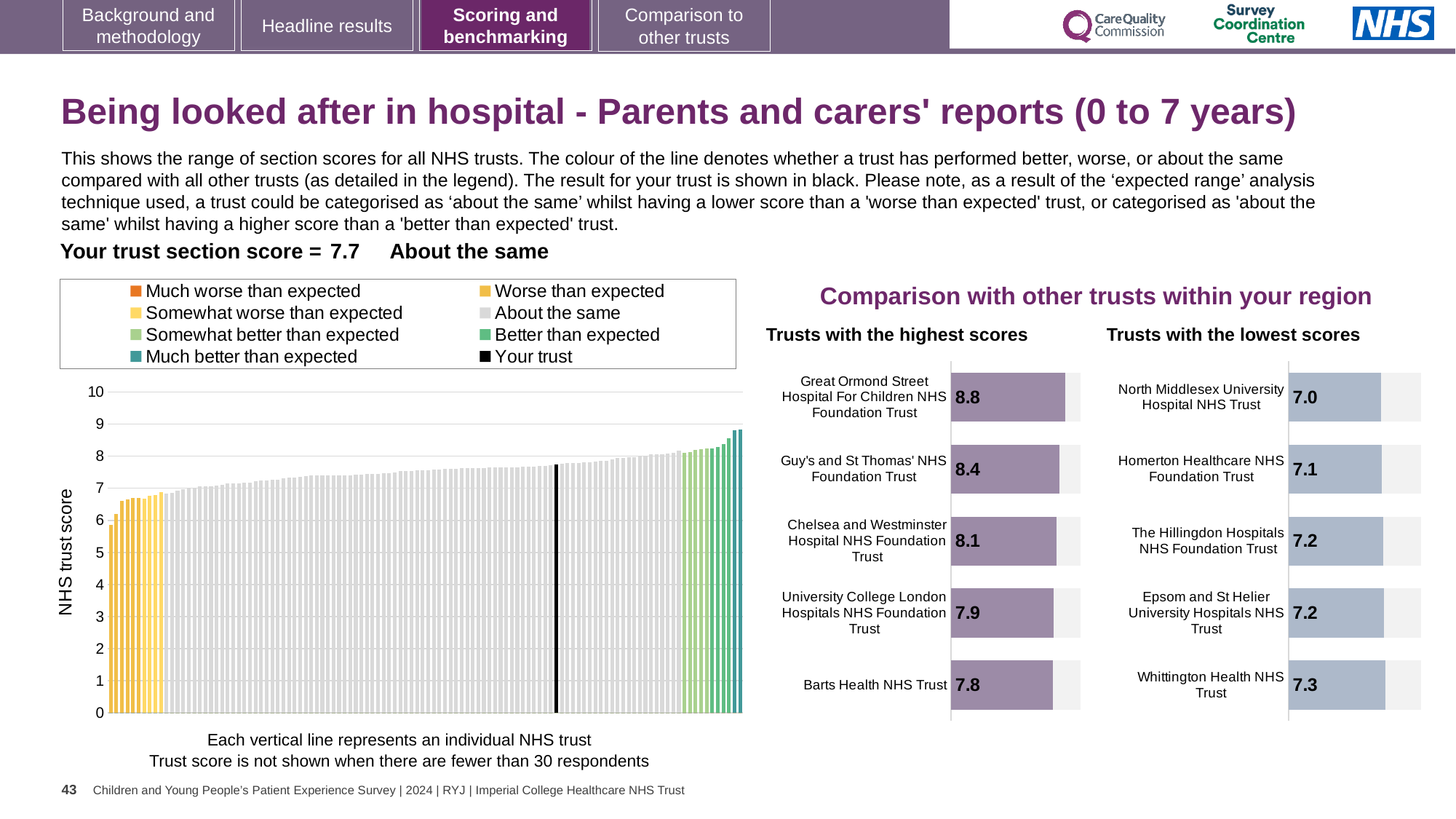
In the 'Trusts with the lowest scores' chart, what is the score for Whittington Health NHS Trust? 7.3 In the 'Trusts with the highest scores' chart, what is the score for Great Ormond Street Hospital For Children NHS Foundation Trust? 8.8 How many trusts are shown in the 'Trusts with the highest scores' chart? 5 In the 'Trusts with the highest scores' chart, which trust has the highest score? Great Ormond Street Hospital For Children NHS Foundation Trust In the 'Trusts with the highest scores' chart, what is the difference between the scores of Great Ormond Street Hospital For Children NHS Foundation Trust and Barts Health NHS Trust? 1.0 In the 'Trusts with the lowest scores' chart, which trust has the lowest score? North Middlesex University Hospital NHS Trust What is the y-axis label of the main chart showing the range of section scores? NHS trust score How many entries does the legend of the main NHS trust score chart list? 8 In the main NHS trust score chart, do the values rise or fall from left to right? rise In the 'Trusts with the lowest scores' chart, which has the higher score: Homerton Healthcare NHS Foundation Trust or The Hillingdon Hospitals NHS Foundation Trust? The Hillingdon Hospitals NHS Foundation Trust What is the section score for your trust shown in black on the main chart? 7.7 What kind of chart is the main chart showing the range of section scores for all NHS trusts? bar chart